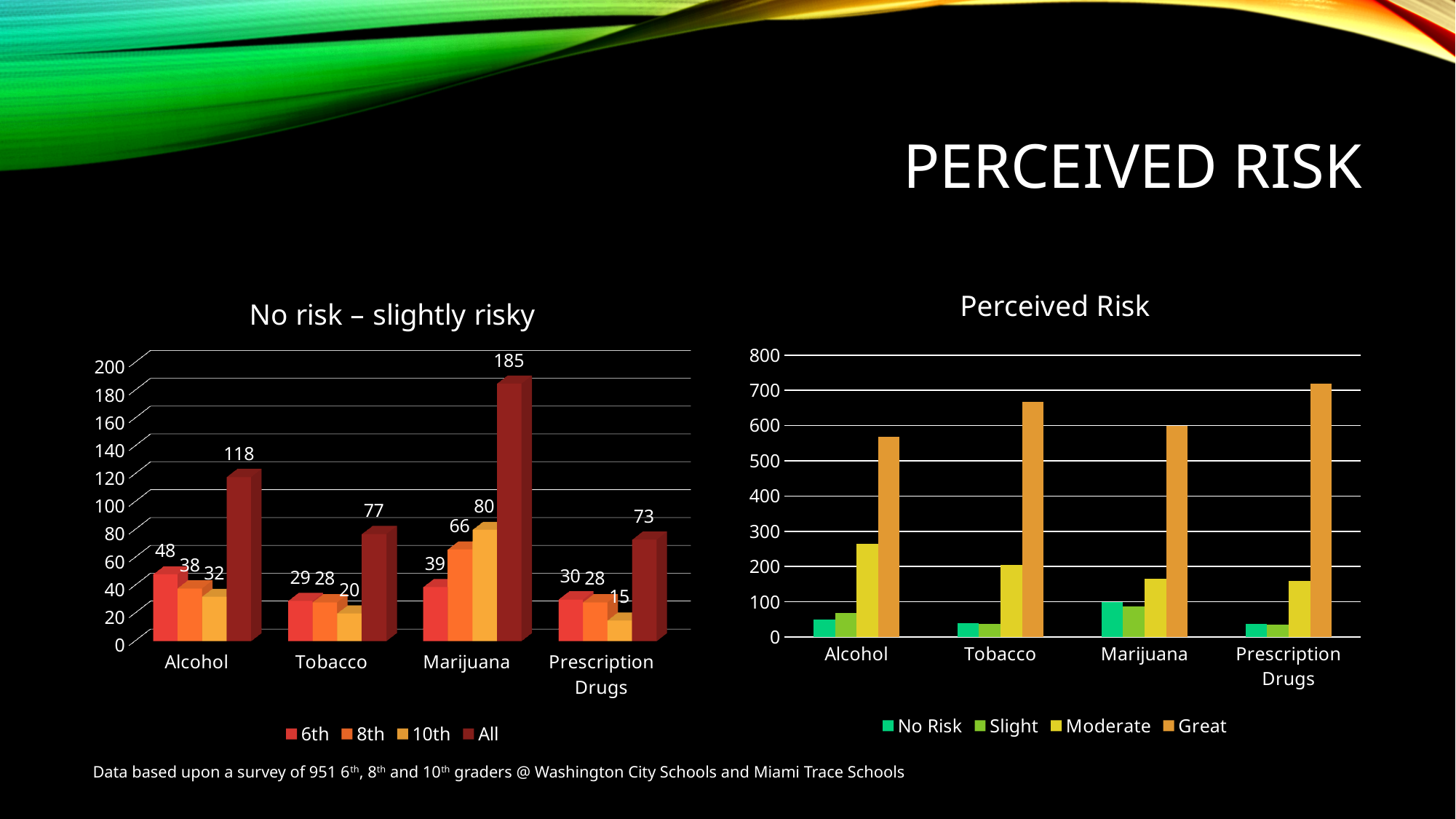
What kind of chart is the 'Perceived Risk' chart on the right? Bar chart In the 'No risk – slightly risky' chart, which category has the highest 'All' value? Marijuana In the 'No risk – slightly risky' chart, which category has the lowest 'All' value? Prescription Drugs In the 'No risk – slightly risky' chart, what is the value for 10th graders for Prescription Drugs? 15 In the 'Perceived Risk' chart, which category has the highest 'Great' value? Prescription Drugs In the 'No risk – slightly risky' chart, which is larger for Marijuana: the 8th grade value or the 10th grade value? 10th In the 'No risk – slightly risky' chart, what is the 'All' value for Marijuana? 185 In the 'Perceived Risk' chart, is the 'Great' value for Prescription Drugs greater or less than 700? greater In the 'No risk – slightly risky' chart, what is the difference between the 'All' values for Alcohol and Tobacco? 41 How many series does the legend of the 'No risk – slightly risky' chart list? 4 In the 'Perceived Risk' chart, which category has the highest 'No Risk' value? Marijuana In the 'No risk – slightly risky' chart, what is the value for 6th graders for Alcohol? 48